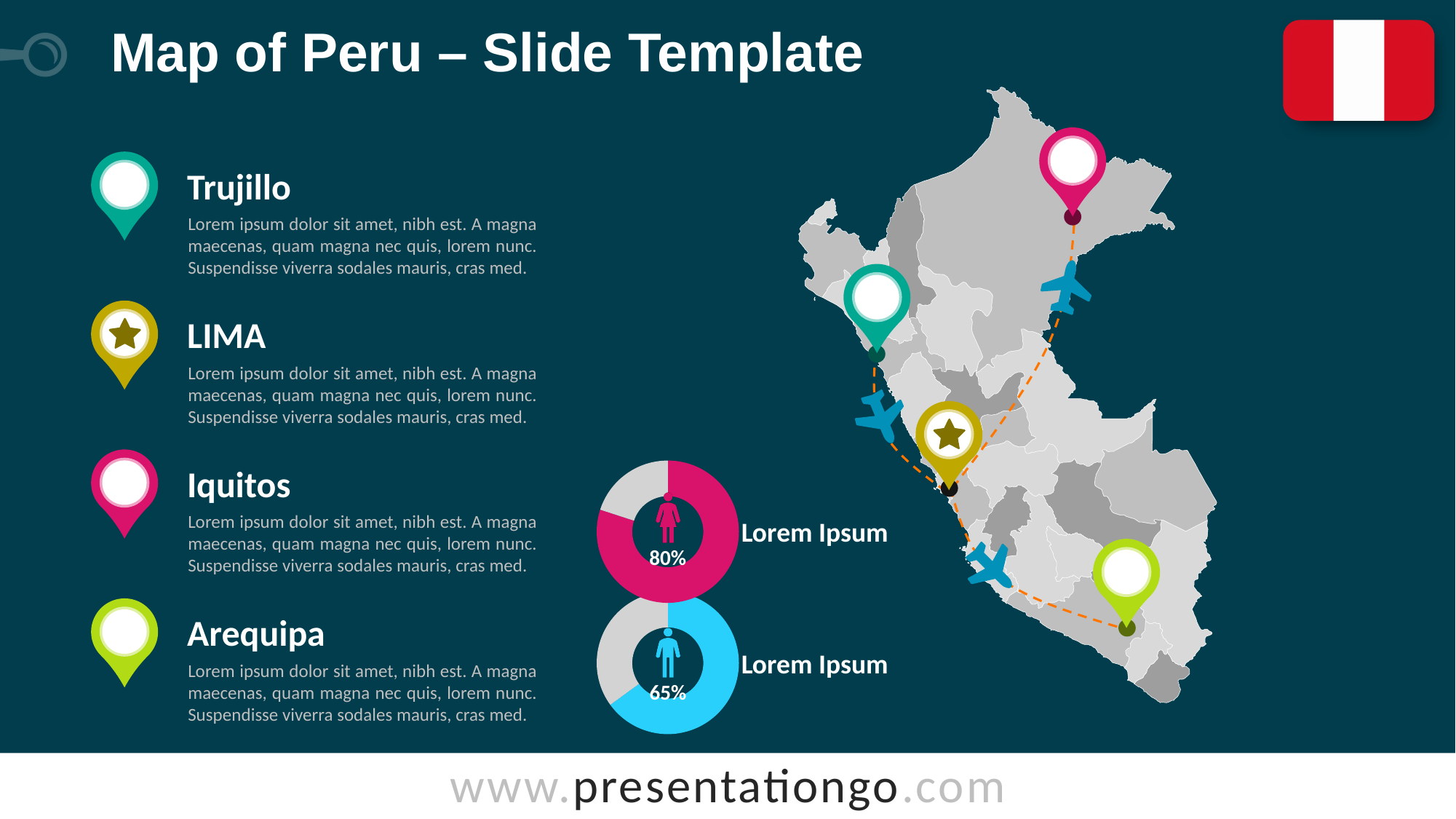
What value is shown in the lower (blue) donut chart with the male icon? 65% What colour is the filled portion of the donut chart showing 65%? Blue Is the value in the pink donut chart greater or less than 75%? greater Which donut chart shows the lowest percentage, the one with the female icon or the one with the male icon? The one with the male icon What is the difference between the percentage in the pink donut chart and the percentage in the blue donut chart? 15% Is the value in the blue donut chart greater or less than 50%? greater What kind of charts are the two circular charts at the bottom centre of the slide? Donut charts What label text appears to the right of each donut chart? Lorem Ipsum What value is shown in the upper (pink) donut chart with the female icon? 80% Which of the two donut charts shows the higher percentage, the pink one or the blue one? The pink one How many donut charts are on the slide? 2